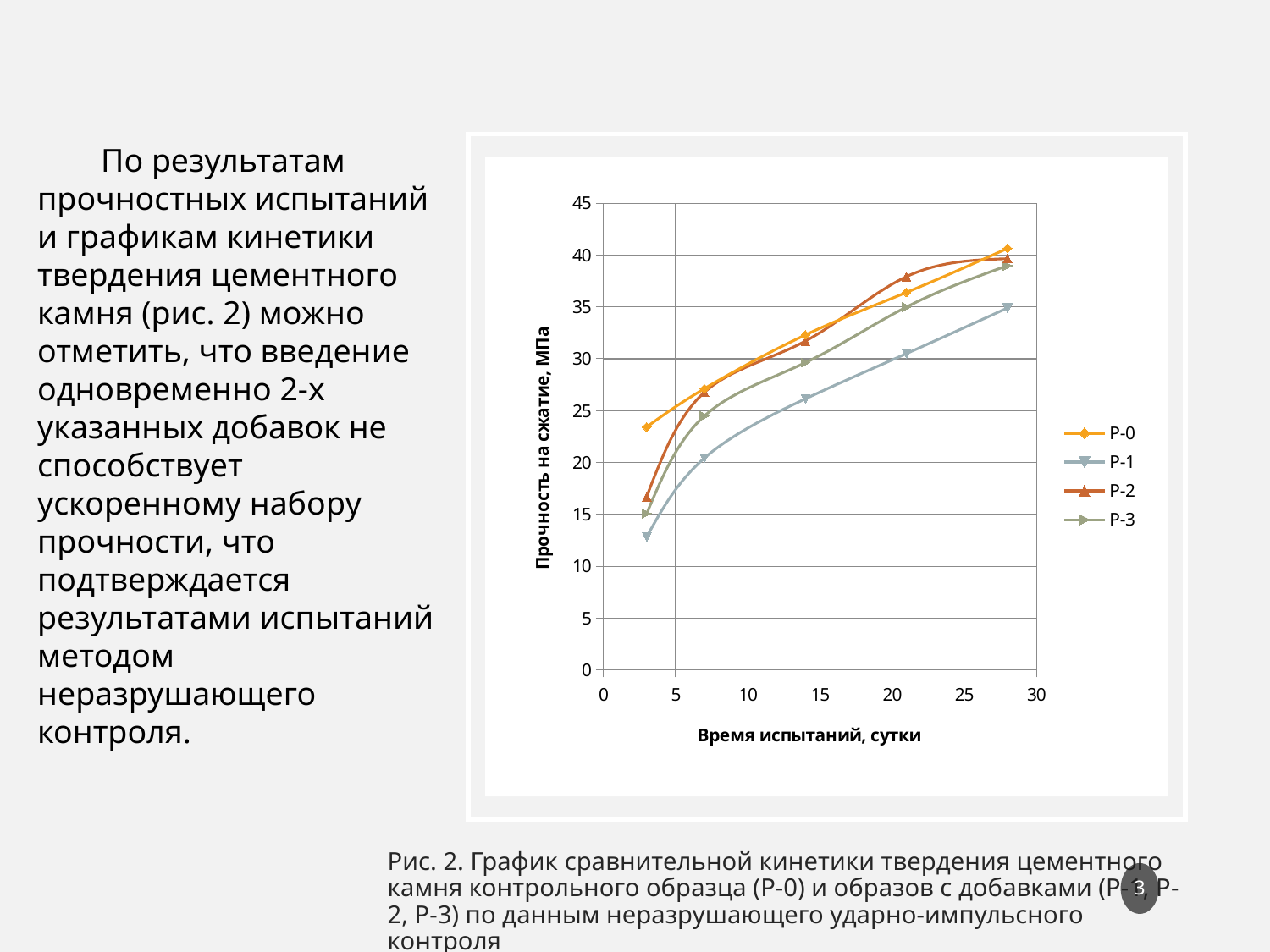
Is the value for Р-0 at 28 days greater or less than 40? greater Which series has the lowest value at 3 days? Р-1 What are the series names listed in the legend? Р-0, Р-1, Р-2, Р-3 How many data points are plotted for each series? 5 At 28 days, which is larger: the value for Р-0 or the value for Р-1? Р-0 How many series does the legend list? 4 Which series has the lowest value at 28 days? Р-1 What is the title of the vertical axis? Прочность на сжатие, МПа Is the value for Р-1 at 3 days greater or less than 15? less Do the values of series Р-1 rise or fall as the test time increases? rise Is the value for Р-2 at 21 days greater or less than 35? greater What kind of chart is shown on the slide? line chart